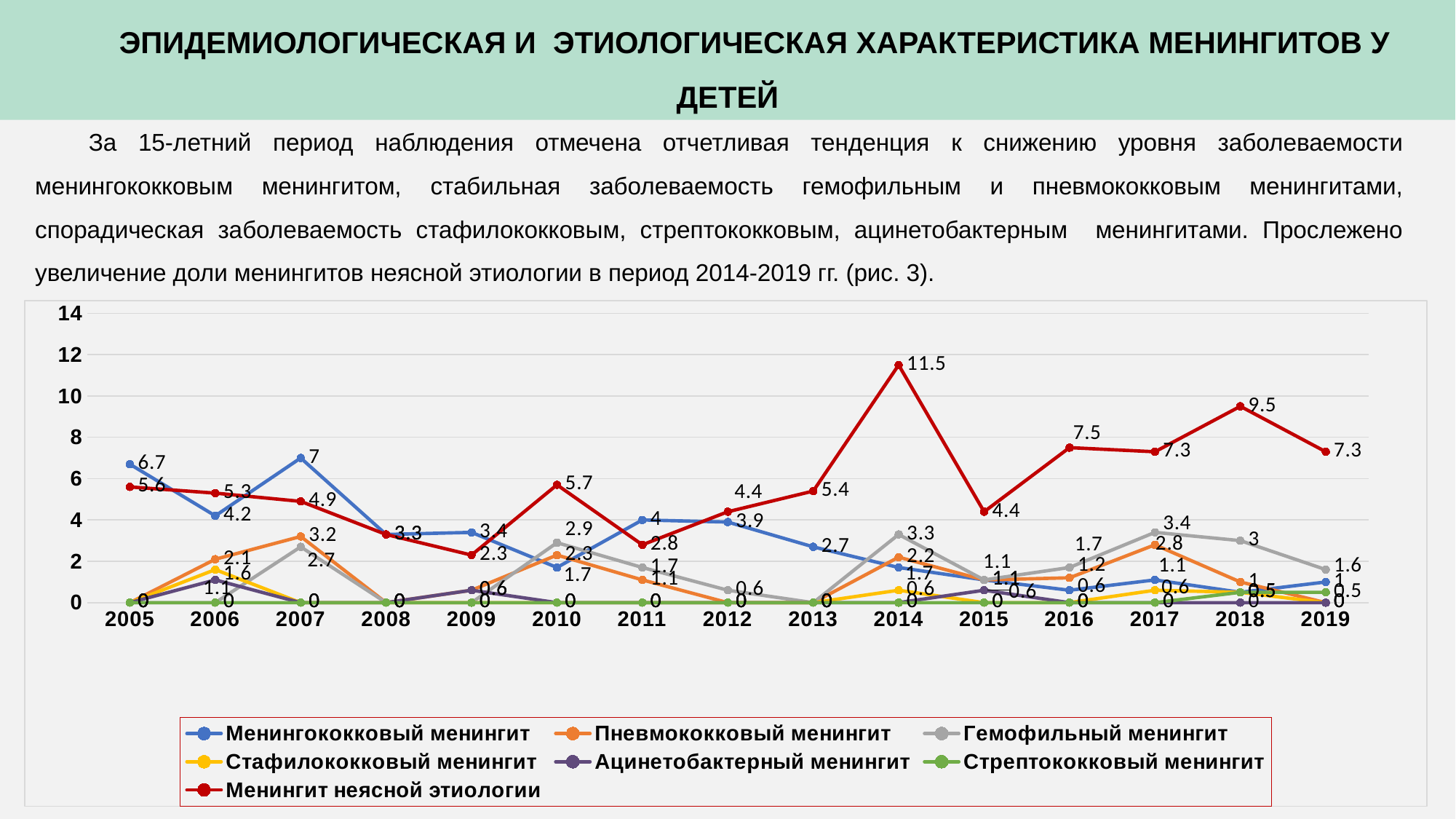
Which series is drawn in red? Менингит неясной этиологии How many years are plotted along the x axis? 15 Does the Менингококковый менингит line generally rise or fall from 2005 to 2019? fall What is the difference between the Менингит неясной этиологии values in 2014 and 2015? 7.1 What kind of chart is shown on the slide? line chart What is the value for Менингококковый менингит in 2005? 6.7 Which is larger: the Менингит неясной этиологии value in 2014 or in 2018? 2014 Is the value for Менингит неясной этиологии in 2014 greater or less than 10? greater What is the value for Менингит неясной этиологии in 2018? 9.5 What is the value for Менингит неясной этиологии in 2014? 11.5 How many series does the legend list? 7 In which year does Менингит неясной этиологии reach its highest value? 2014